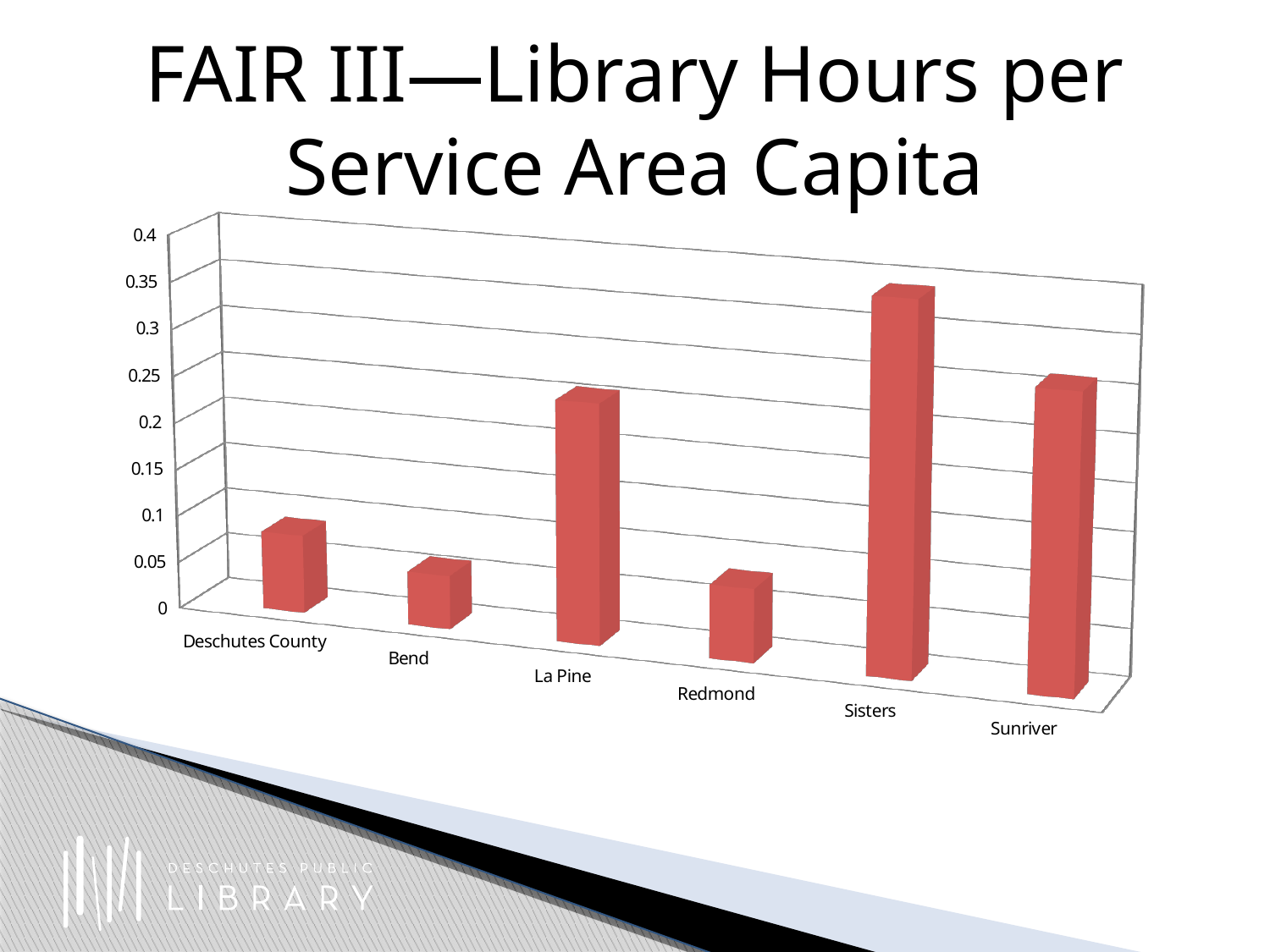
Which is larger, the value for Sisters or the value for Sunriver? Sisters What type of chart is shown on the slide? bar chart Is the value for Redmond greater or less than 0.1? less What is the title of the slide containing the chart? FAIR III—Library Hours per Service Area Capita Which category has the highest library hours per service area capita? Sisters Is the value for Bend greater or less than 0.1? less Is the value for Deschutes County greater or less than 0.1? less How many categories are shown on the x axis of the chart? 6 Which is larger, the value for La Pine or the value for Deschutes County? La Pine